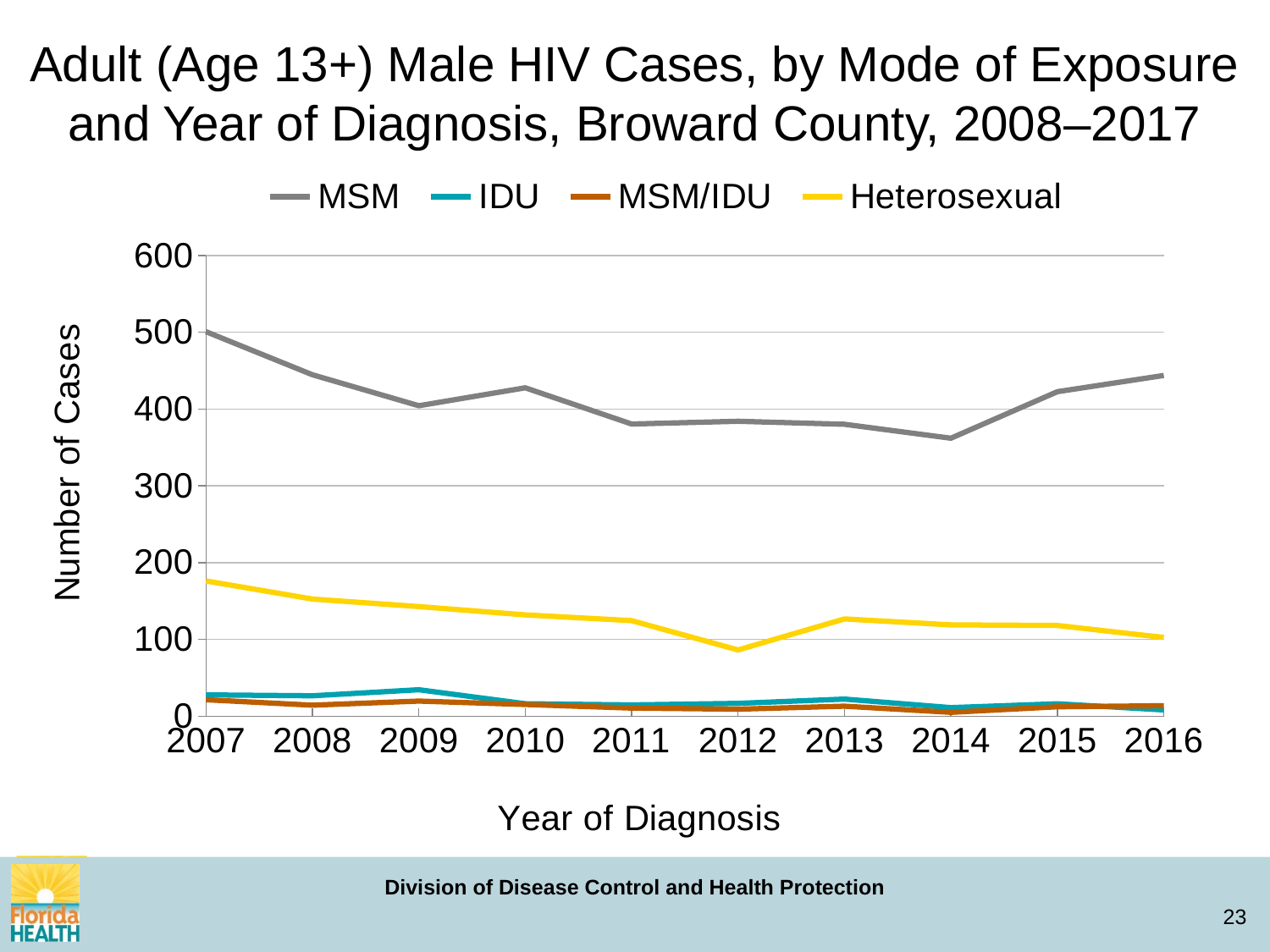
How many series does the legend list? 4 Is the MSM value for 2016 greater or less than 400? greater Is the Heterosexual value for 2007 greater or less than 150? greater In which year is the MSM line at its lowest? 2014 Which is larger, the MSM value in 2007 or in 2016? 2007 Does the Heterosexual line rise or fall from 2007 to 2012? fall What kind of chart is shown on the slide? Line chart Is the MSM value for 2014 greater or less than 400? less Which mode of exposure has the highest number of cases across all years? MSM In which year is the Heterosexual line at its highest? 2007 How many years are shown along the x axis? 10